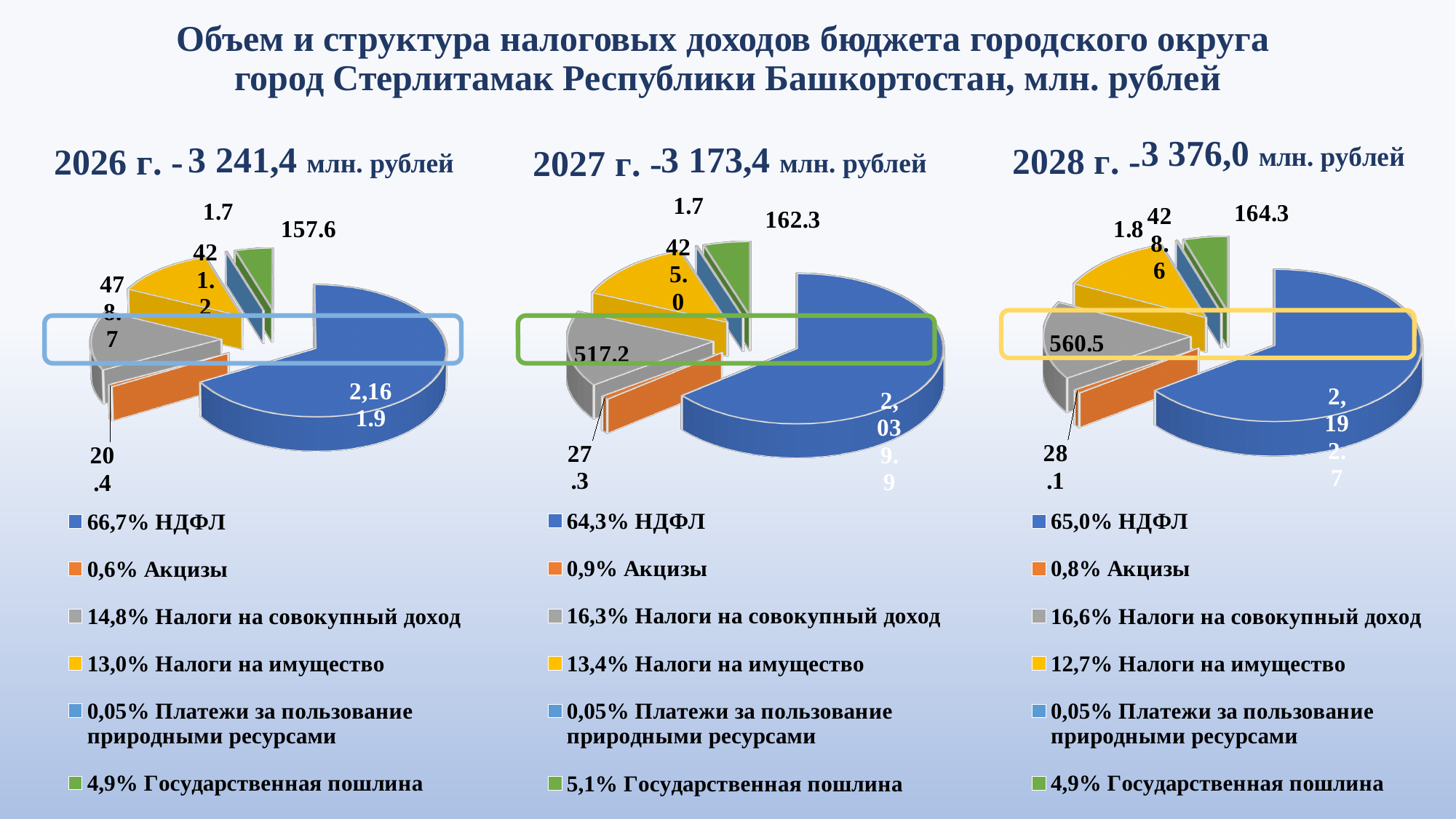
In the 2027 pie chart, what is the difference between Государственная пошлина and Акцизы? 135.0 In the 2028 pie chart, what share of the total does Налоги на имущество account for? 12,7% In the 2026 pie chart, which category has the smallest value? Платежи за пользование природными ресурсами In the 2026 pie chart, what share of the total does НДФЛ account for? 66,7% In the 2027 pie chart, which category has the largest value? НДФЛ In the 2026 pie chart, what is the value for Государственная пошлина? 157.6 In the 2028 pie chart, what is the value for Налоги на совокупный доход? 560.5 In the 2027 pie chart, what is the value for Налоги на совокупный доход? 517.2 In the 2028 pie chart, what is the value for Государственная пошлина? 164.3 How many slices does the 2027 pie chart have? 6 In the 2026 pie chart, which is larger: Налоги на совокупный доход or Налоги на имущество? Налоги на совокупный доход What kind of chart is used for each year on this slide? Pie chart